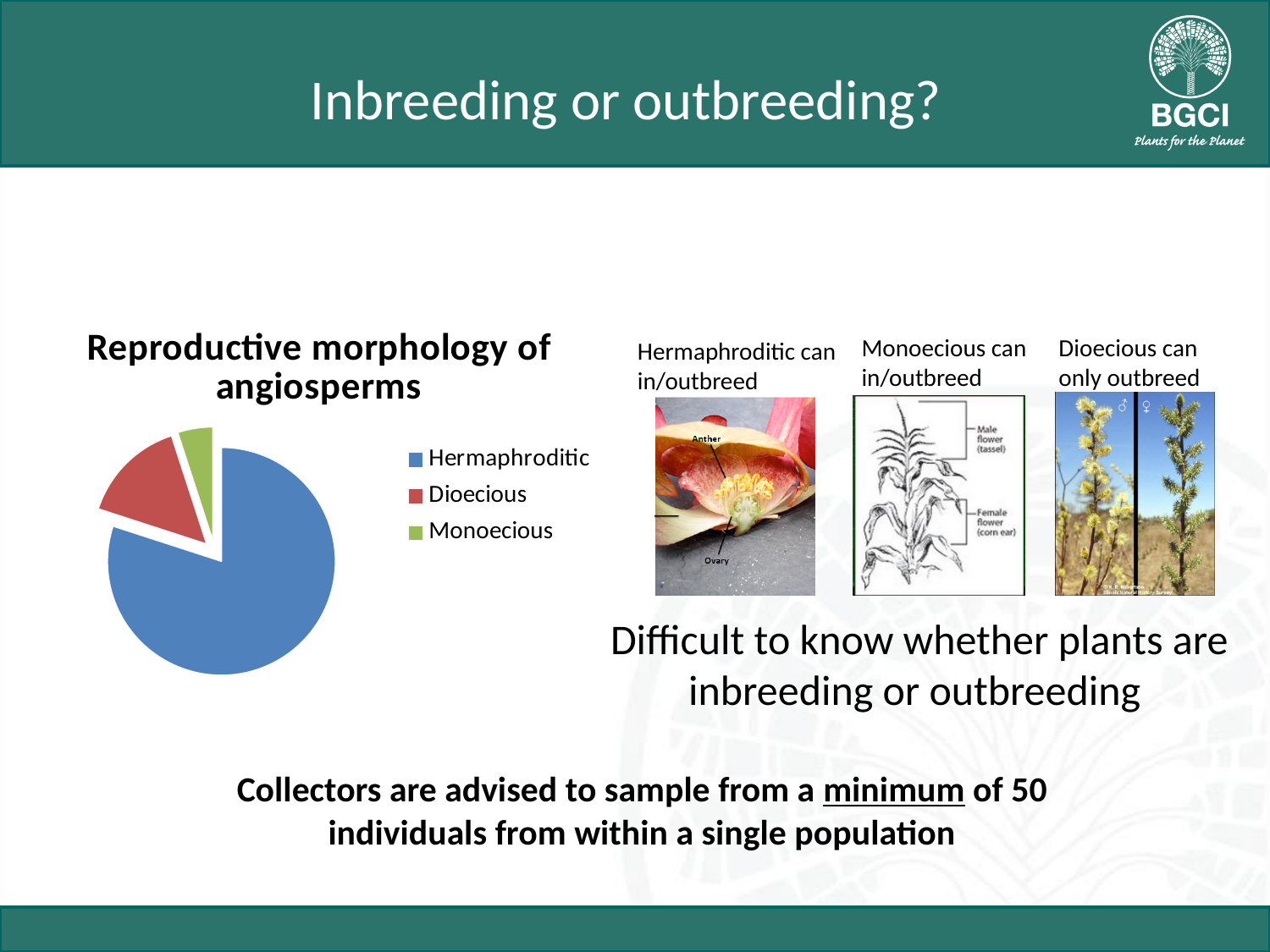
Which category has the largest slice in the pie chart? Hermaphroditic In the pie chart, which slice is larger: Dioecious or Monoecious? Dioecious Which category has the smallest slice in the pie chart? Monoecious How many entries does the legend of the pie chart list? 3 In the pie chart, which slice is larger: Hermaphroditic or Dioecious? Hermaphroditic What colour is the Dioecious slice in the pie chart? red How many categories does the pie chart show? 3 What kind of chart is shown on the slide? pie chart What is the title of the pie chart? Reproductive morphology of angiosperms